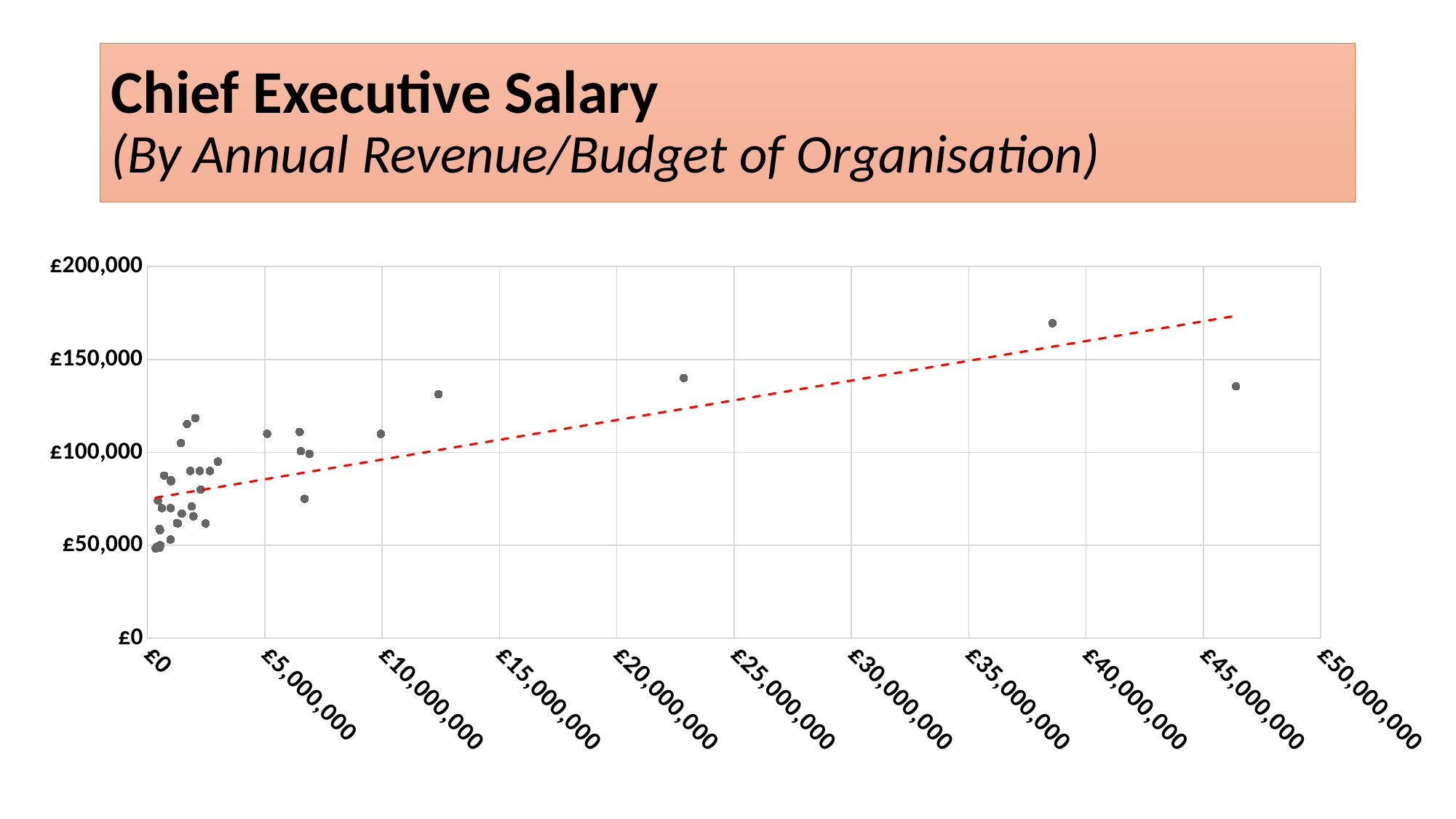
Is the salary for the point near £22,000,000 revenue greater or less than £100,000? greater Is the salary for the point near £12,000,000 revenue greater or less than £100,000? greater What kind of chart is shown on the slide? Scatter chart What is the highest value shown on the y axis? £200,000 Is the salary for the rightmost point (near £46,000,000 revenue) greater or less than £150,000? less What is the title of the chart? Chief Executive Salary (By Annual Revenue/Budget of Organisation) Which has the higher salary: the point near £38,000,000 revenue or the rightmost point near £46,000,000 revenue? The point near £38,000,000 What colour and style is the trend line on the chart? Red dashed Does the dashed trend line rise or fall as annual revenue increases along the x axis? Rises